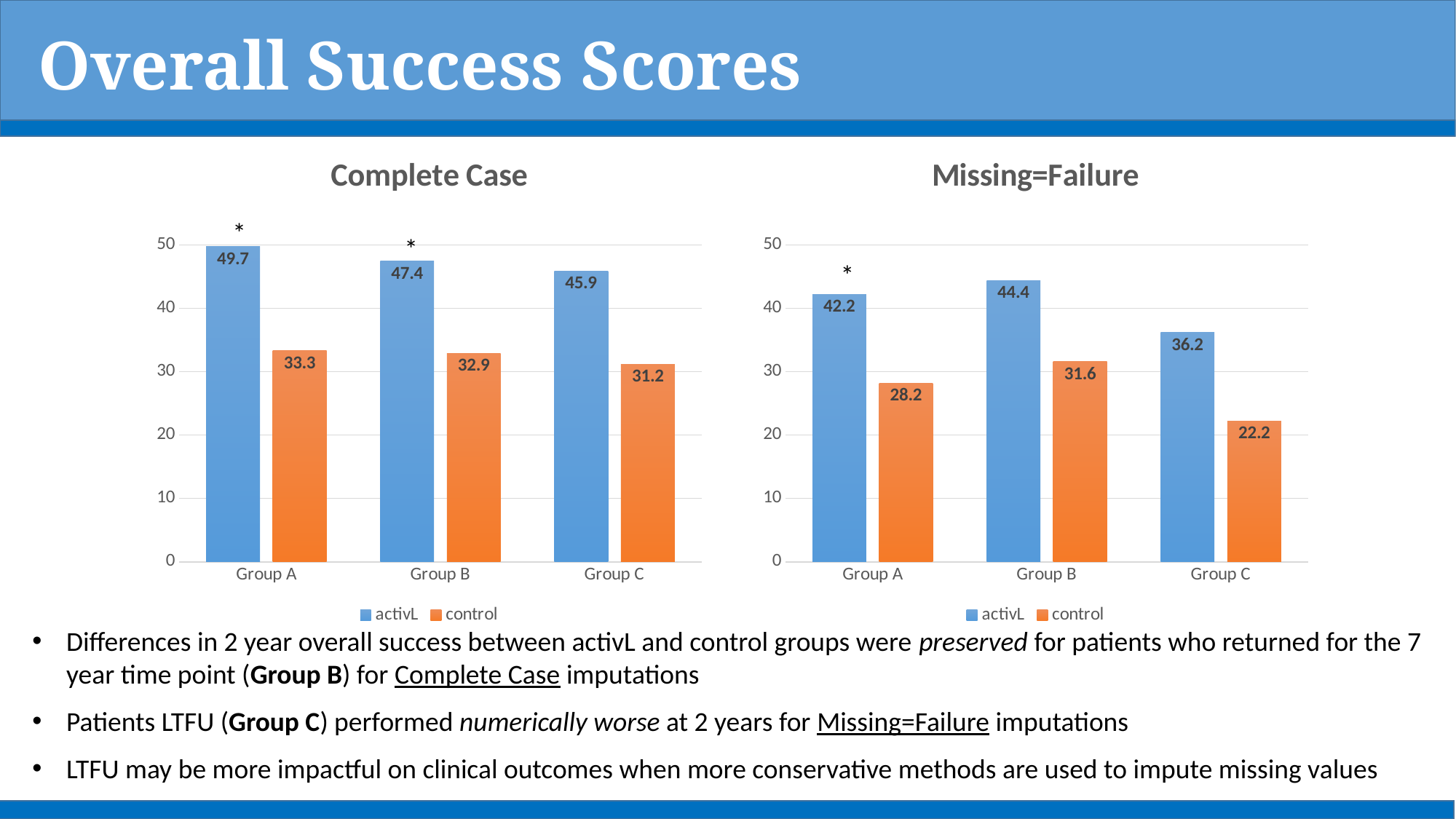
In the Complete Case chart, what is the control value for Group C? 31.2 In the Missing=Failure chart, which group has the highest activL value? Group B In the Missing=Failure chart, which group has the lowest control value? Group C How many groups are shown on the x axis of the Complete Case chart? 3 In the Complete Case chart, what is the difference between the activL and control values for Group B? 14.5 How many series does the legend of the Missing=Failure chart list? 2 What type of chart is the Complete Case chart? Bar chart In the Missing=Failure chart, what is the control value for Group A? 28.2 In the Complete Case chart, which is larger: the activL value for Group C or the control value for Group A? activL value for Group C In the Missing=Failure chart, what is the activL value for Group C? 36.2 In the Complete Case chart, what is the activL value for Group A? 49.7 In the Missing=Failure chart, what is the difference between the activL and control values for Group C? 14.0